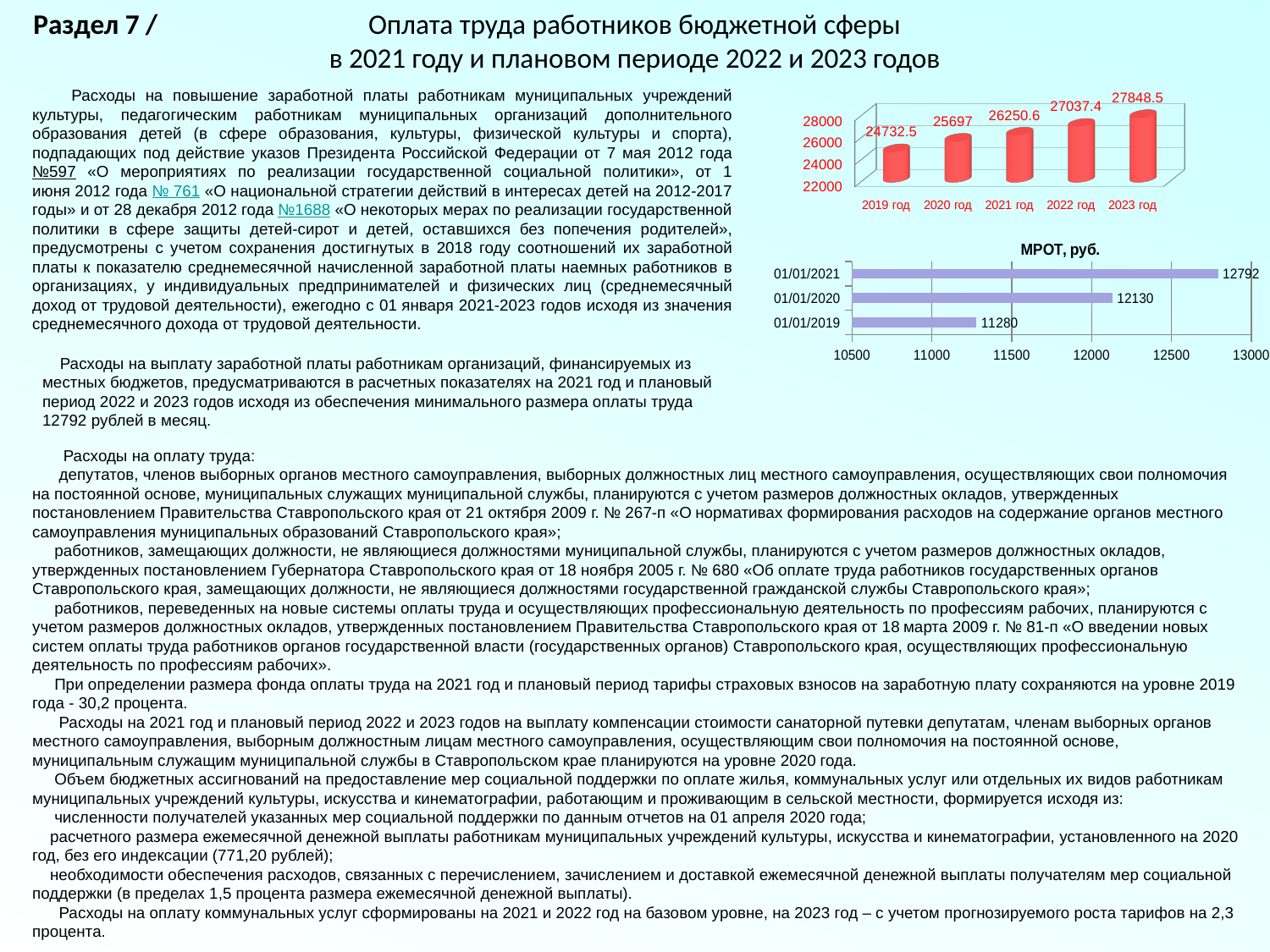
In the upper chart on the right, what is the difference between the values for 2023 год and 2022 год? 811.1 In the upper chart on the right, what is the value for 2021 год? 26250.6 In the chart titled 'МРОТ, руб.', what is the difference between the values for 01/01/2021 and 01/01/2019? 1512 In the chart titled 'МРОТ, руб.', what is the value for 01/01/2020? 12130 What kind of chart is the chart titled 'МРОТ, руб.'? bar chart In the upper chart on the right, which year has the highest value? 2023 год In the upper chart on the right, do the values rise or fall from 2019 год to 2023 год? rise In the upper chart on the right, which year has the lowest value? 2019 год In the upper chart on the right, how many years are plotted? 5 In the chart titled 'МРОТ, руб.', what is the value for 01/01/2019? 11280 In the chart titled 'МРОТ, руб.', which date has the larger value, 01/01/2021 or 01/01/2020? 01/01/2021 In the upper chart on the right, what is the value for 2019 год? 24732.5